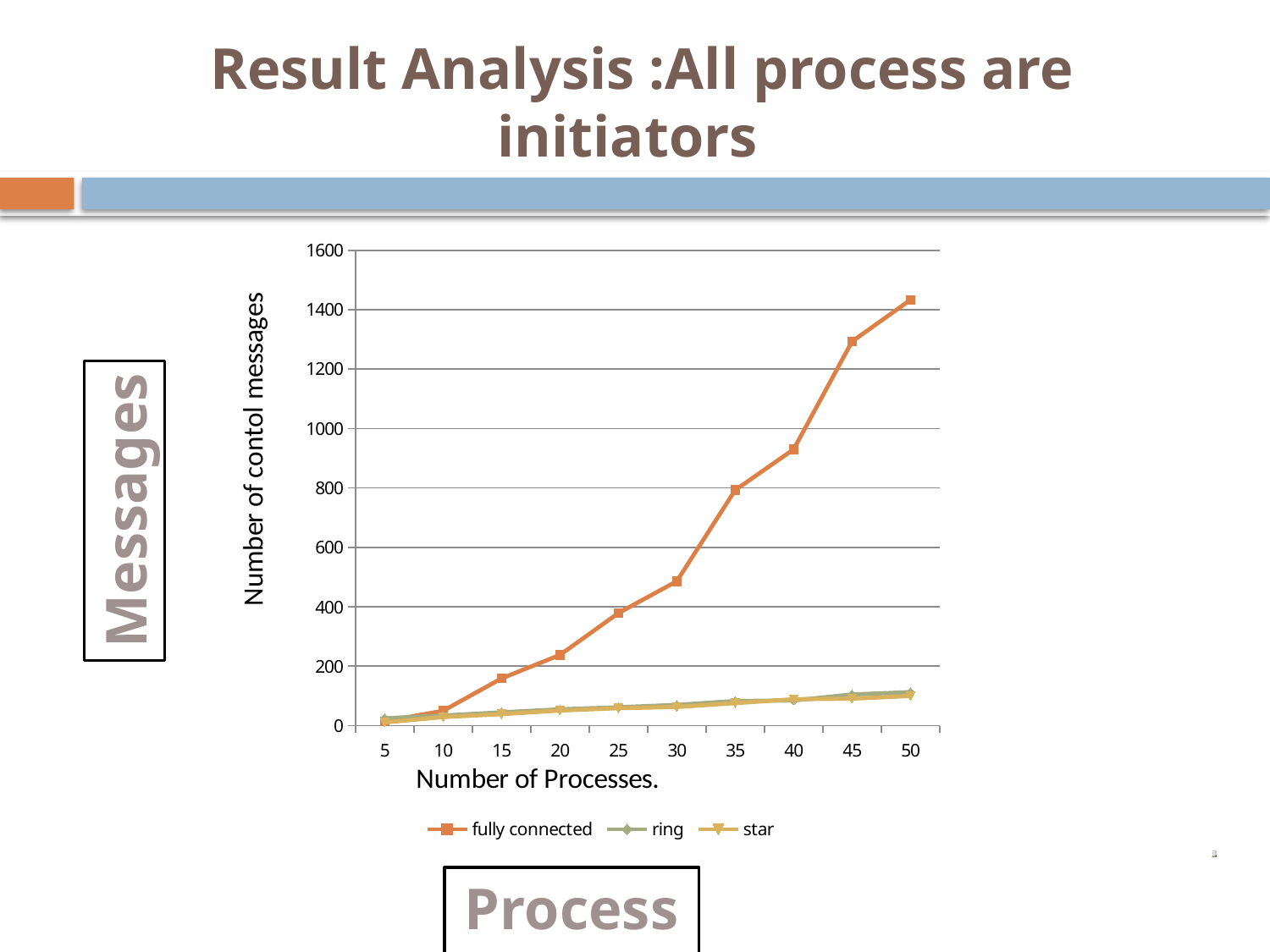
At 35 processes, which is larger: the value for fully connected or the value for star? fully connected What are the three series named in the legend? fully connected, ring, star Is the value for the ring series at 50 processes greater or less than 200? less Which series has the highest value at 50 processes? fully connected Is the value for the fully connected series at 45 processes greater or less than 1200? greater How many points along the x axis (Number of Processes) are plotted for each series? 10 Does the number of control messages for the fully connected series rise or fall as the number of processes increases? rise Is the value for the fully connected series at 40 processes greater or less than 800? greater What kind of chart is shown on the slide? line chart What is the title of the vertical axis? Number of contol messages How many series does the legend list? 3